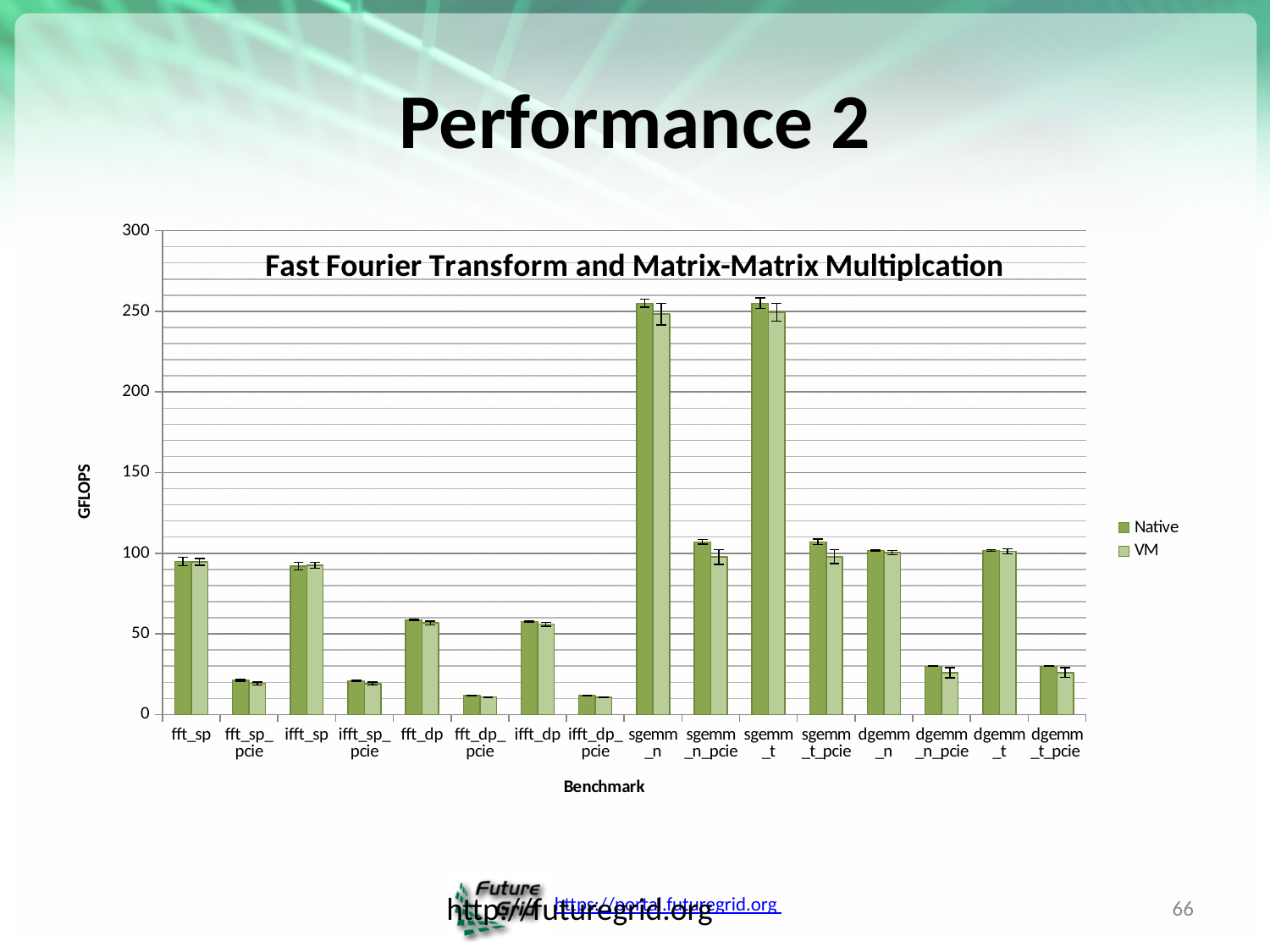
What is the title of the chart? Fast Fourier Transform and Matrix-Matrix Multiplcation What is the label of the y axis? GFLOPS Is the Native value for sgemm_n greater or less than 250? greater Which has the larger Native value, fft_sp or fft_sp_pcie? fft_sp Is the VM value for dgemm_n_pcie greater or less than 50? less For sgemm_n_pcie, which series has the larger value, Native or VM? Native Is the Native value for fft_sp greater or less than 100? less What kind of chart is shown on the slide? bar chart How many series does the legend list? 2 How many benchmark categories are shown on the x axis? 16